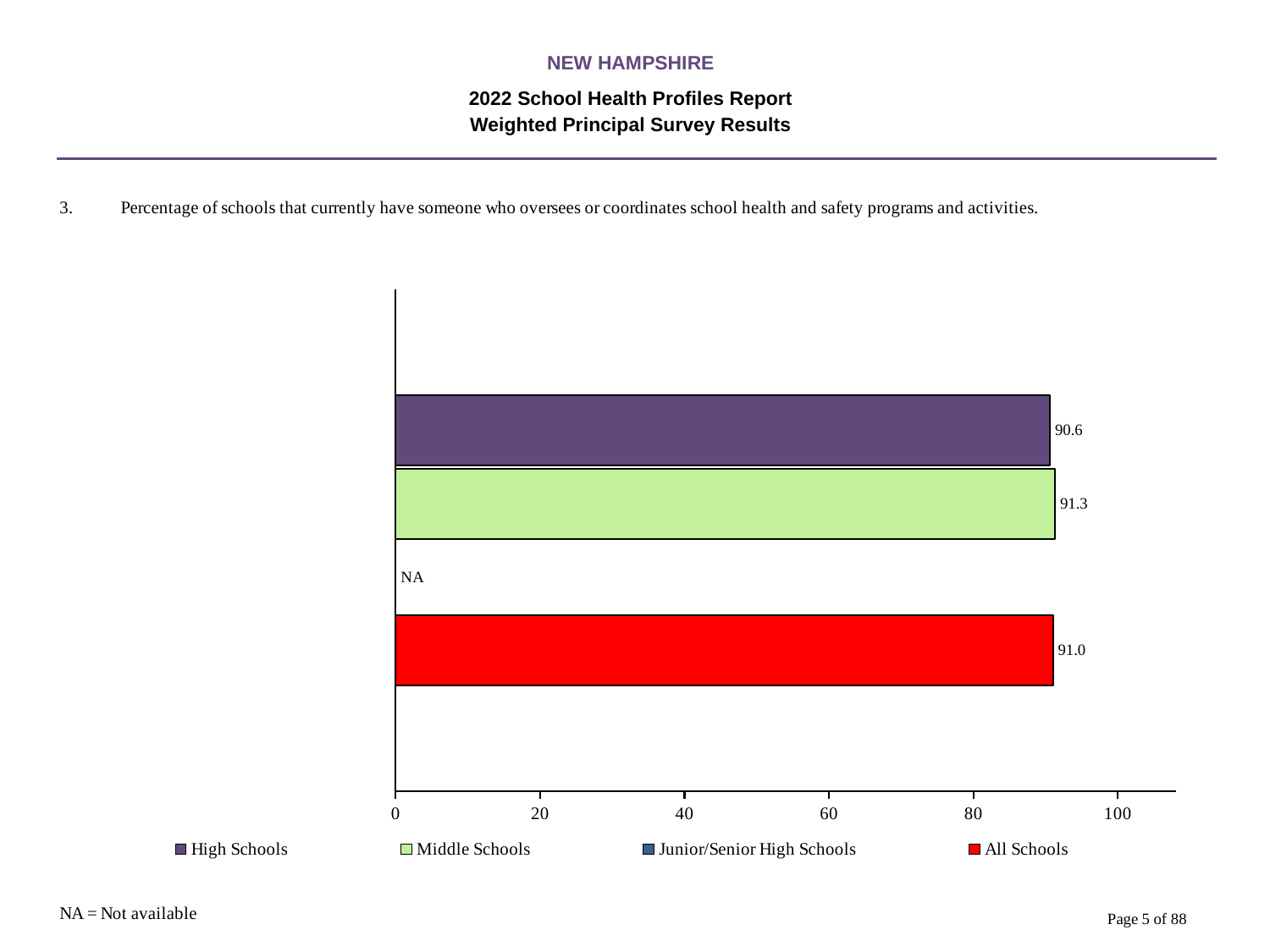
What is the value for Middle Schools? 91.3 Which school type has the highest value among those with a plotted bar? Middle Schools What kind of chart is shown on the slide? Bar chart What is the value for All Schools? 91.0 What is the difference between the All Schools value and the High Schools value? 0.4 What colour is the bar for All Schools? Red How many series does the legend list? 4 Is the value for All Schools greater or less than 80? greater What is shown for Junior/Senior High Schools? NA What is the value for High Schools? 90.6 Which school type has the lowest value among those with a plotted bar? High Schools What is the difference between the Middle Schools value and the High Schools value? 0.7